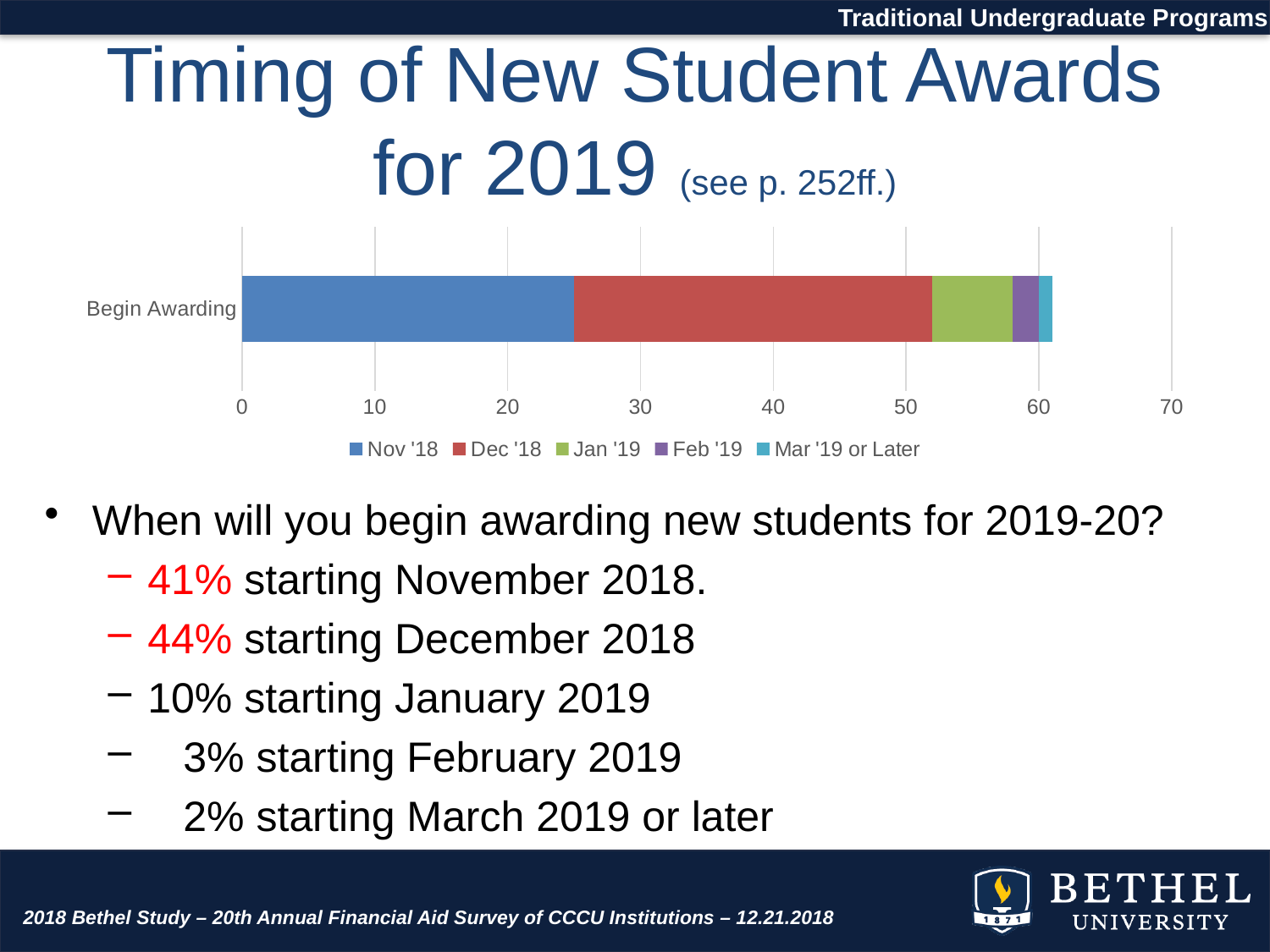
Is the total length of the stacked bar greater or less than 70? less Is the value for Nov '18 greater or less than 20? greater How many categories are plotted on the y axis? 1 Which series is listed first in the legend? Nov '18 What kind of chart is shown on the slide? bar chart Is the value for Nov '18 greater or less than 30? less How many series does the legend list? 5 What is the label of the single category on the y axis? Begin Awarding Which is larger, the Nov '18 segment or the Jan '19 segment? Nov '18 Which series has the smallest segment in the stacked bar? Mar '19 or Later